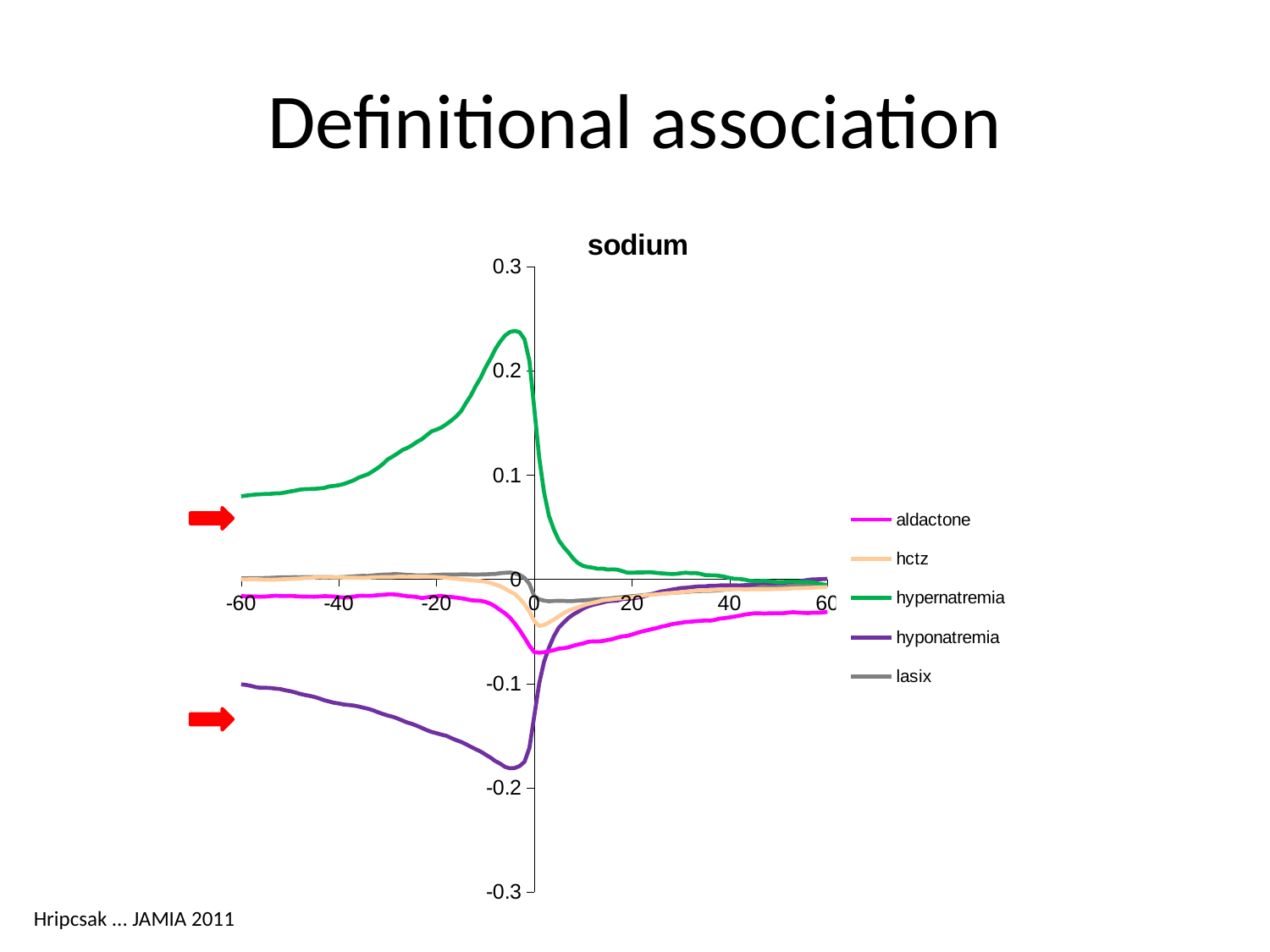
At x = -60, which series has the larger value, hypernatremia or hyponatremia? hypernatremia Is the lowest value of the hyponatremia series greater or less than -0.1? less How many series does the legend list? 5 Is the peak value of the hypernatremia series greater or less than 0.2? greater Is the lowest value of the aldactone series greater or less than -0.1? greater What kind of chart is shown on the slide? line chart Which series reaches the lowest value on the chart? hyponatremia What is the title of the chart? sodium Which series is drawn in green? hypernatremia Which series reaches the highest value on the chart? hypernatremia Does the hyponatremia series rise or fall as x goes from 0 to 60? rise Does the hypernatremia series rise or fall as x goes from -60 toward 0? rise